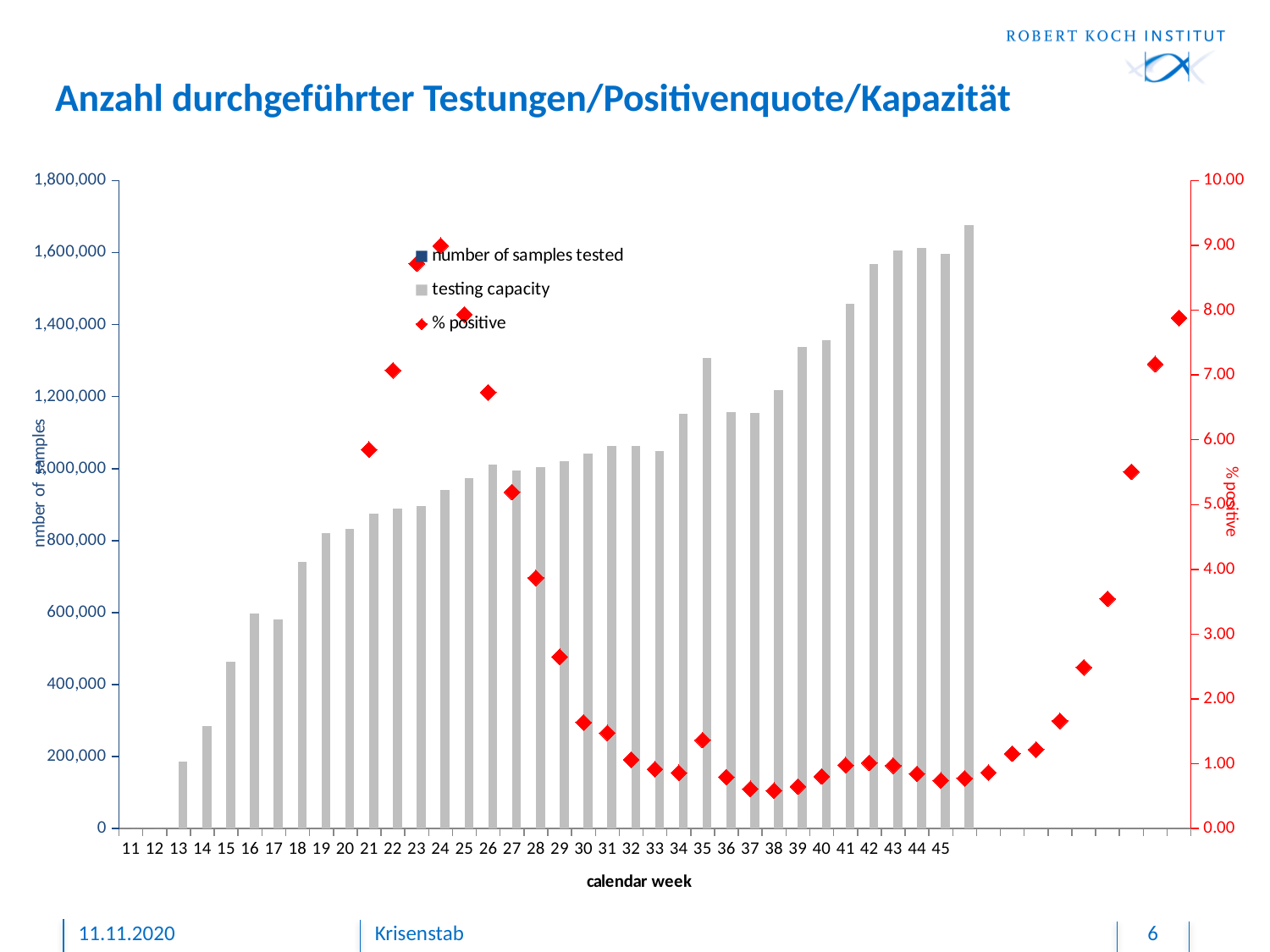
Which calendar week has the higher % positive value, week 23 or week 32? week 23 Is the % positive value for calendar week 29 greater or less than 3.00? less Is the testing capacity for calendar week 35 greater or less than 1,200,000? greater What are the three entries in the chart legend? number of samples tested, testing capacity, % positive Is the % positive value for calendar week 24 greater or less than 8.00? greater Does the testing capacity generally rise or fall from calendar week 13 to week 45? rise Among the labeled calendar weeks, which week has the lowest testing capacity? week 13 Which calendar week has the higher testing capacity, week 15 or week 18? week 18 What kind of chart is used to show the testing capacity series? bar chart How many series does the legend list? 3